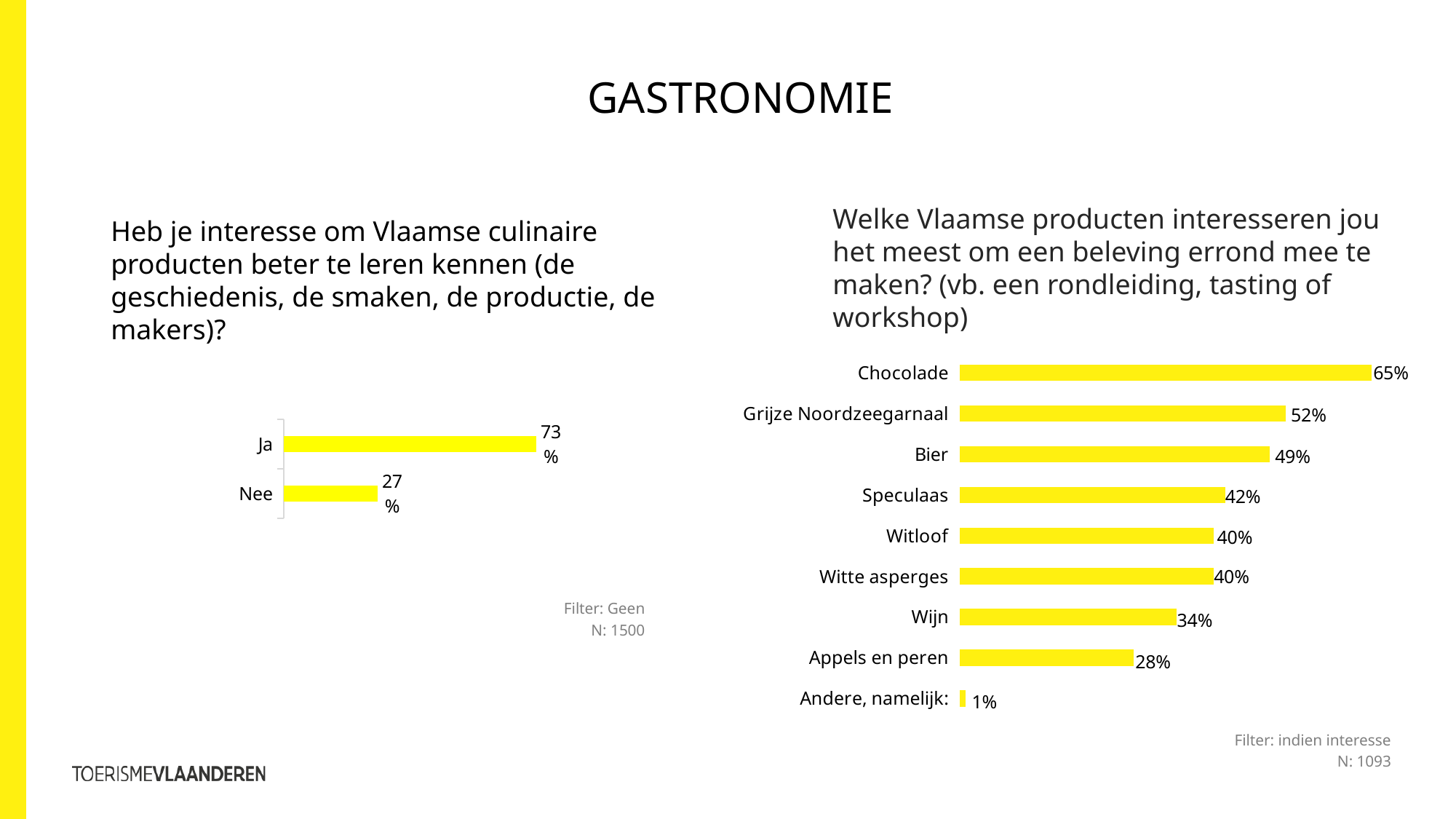
In the right chart (Welke Vlaamse producten interesseren jou het meest), what is the value for Bier? 49% In the right chart (Welke Vlaamse producten interesseren jou het meest), how many categories are shown? 9 In the left chart (Heb je interesse om Vlaamse culinaire producten beter te leren kennen), what is the value for Nee? 27% What is the N shown below the right chart (Welke Vlaamse producten interesseren jou het meest)? 1093 In the right chart (Welke Vlaamse producten interesseren jou het meest), which category has the lowest value? Andere, namelijk: In the left chart (Heb je interesse om Vlaamse culinaire producten beter te leren kennen), what is the value for Ja? 73% In the right chart (Welke Vlaamse producten interesseren jou het meest), what is the difference between Chocolade and Grijze Noordzeegarnaal? 13% In the right chart (Welke Vlaamse producten interesseren jou het meest), which is larger, Speculaas or Appels en peren? Speculaas In the right chart (Welke Vlaamse producten interesseren jou het meest), which category has the highest value? Chocolade In the left chart (Heb je interesse om Vlaamse culinaire producten beter te leren kennen), what is the difference between Ja and Nee? 46% What kind of chart is the right chart (Welke Vlaamse producten interesseren jou het meest)? Bar chart In the right chart (Welke Vlaamse producten interesseren jou het meest), what is the value for Wijn? 34%